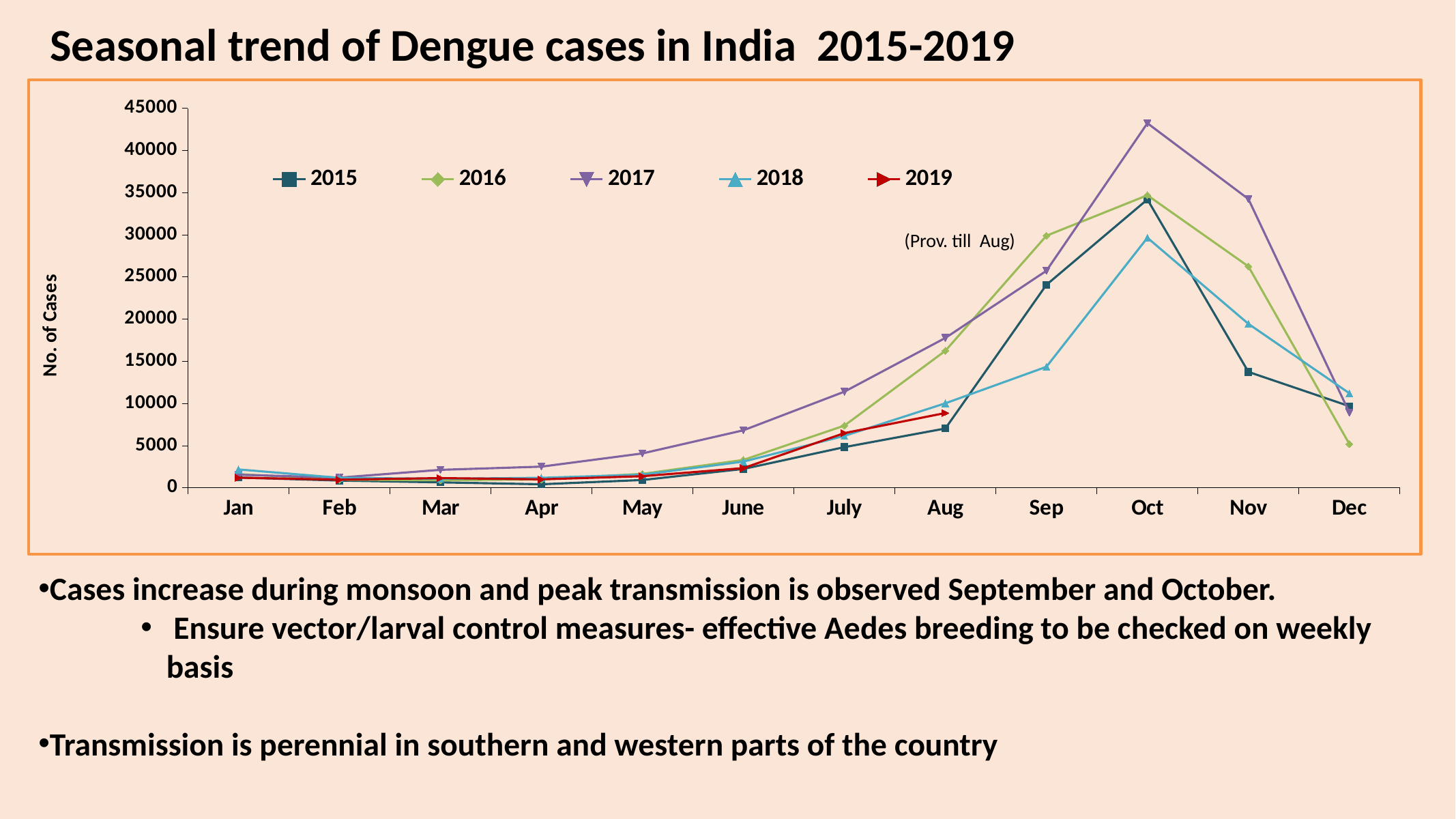
In Sep, which is larger: the value for 2015 or the value for 2018? 2015 Does the 2017 series rise or fall from Oct to Dec? fall What is the label on the y axis? No. of Cases In which month does the 2017 series reach its highest value? Oct How many months are shown along the x axis? 12 Which year reaches the highest number of cases in October? 2017 Is the value for 2017 in Nov greater or less than 30000? greater Is the value for 2017 in Oct greater or less than 40000? greater How many series does the legend list? 5 What kind of chart is shown on the slide? line chart In Nov, which is larger: the value for 2016 or the value for 2015? 2016 Is the value for 2015 in Nov greater or less than 15000? less